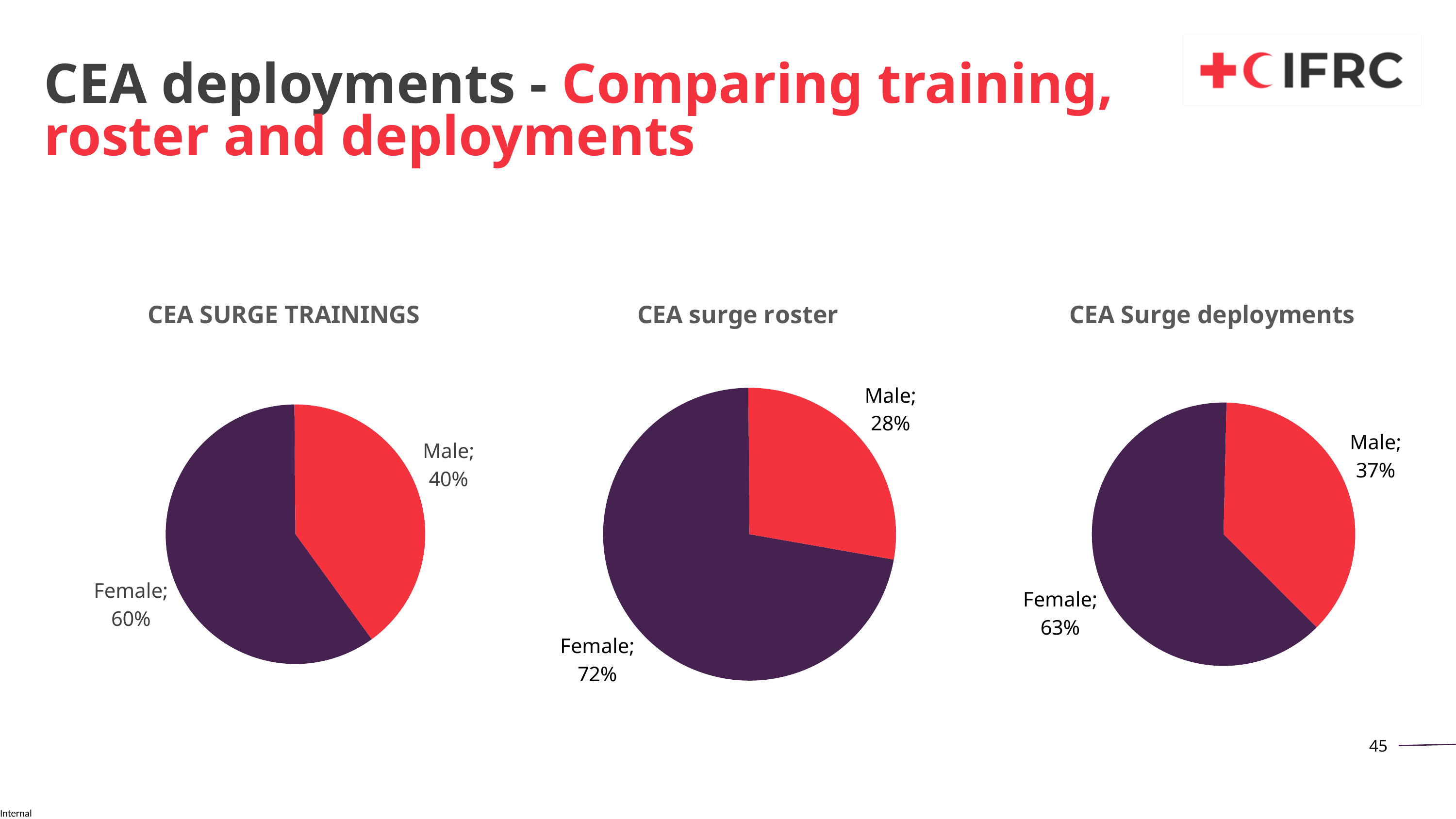
How many slices does the CEA Surge deployments chart have? 2 In the CEA Surge deployments chart, what share of the pie is Female? 63% In the CEA SURGE TRAININGS chart, what is the difference between the Female and Male shares? 20% Is the Male share larger in the CEA surge roster chart or in the CEA Surge deployments chart? CEA Surge deployments What kind of chart is the CEA surge roster chart? Pie chart In the CEA Surge deployments chart, what is the value for Male? 37% In the CEA SURGE TRAININGS chart, what is the value for Female? 60% In the CEA Surge deployments chart, which slice is the smallest? Male In the CEA SURGE TRAININGS chart, what share of the pie is Male? 40% In the CEA surge roster chart, what share of the pie is Female? 72% In the CEA surge roster chart, which slice is the largest? Female In the CEA surge roster chart, what is the value for Male? 28%